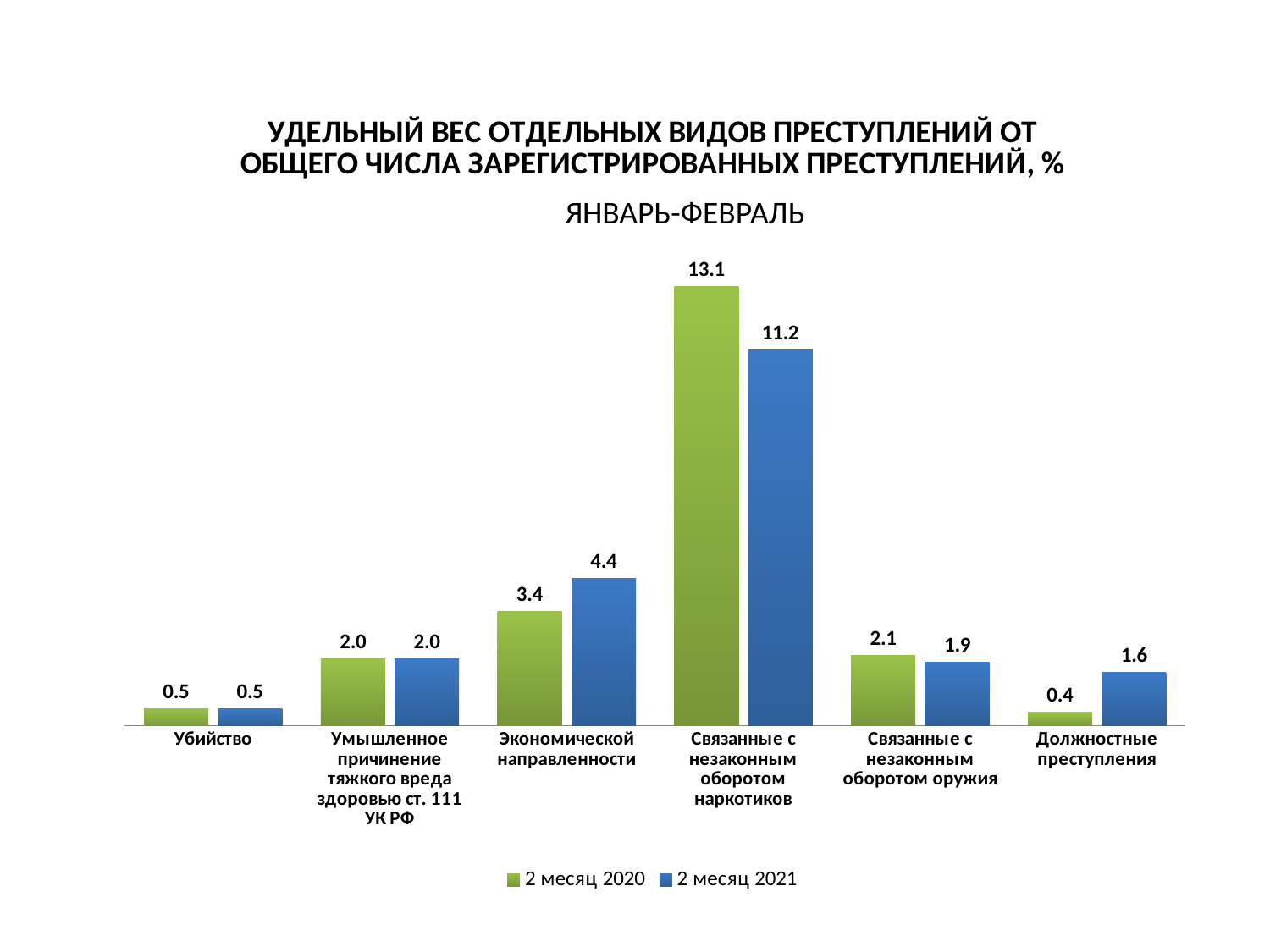
What kind of chart is shown on the slide? Bar chart Which colour represents the '2 месяц 2021' series? Blue What is the value for 'Связанные с незаконным оборотом наркотиков' in the '2 месяц 2021' series? 11.2 Which category has the lowest value in the '2 месяц 2020' series? Должностные преступления Which is larger for 'Связанные с незаконным оборотом оружия': the '2 месяц 2020' value or the '2 месяц 2021' value? 2 месяц 2020 What is the difference between the '2 месяц 2021' and '2 месяц 2020' values for 'Экономической направленности'? 1.0 What is the value for 'Должностные преступления' in the '2 месяц 2021' series? 1.6 How many categories are shown on the x axis? 6 How many series does the legend list? 2 What is the difference between the '2 месяц 2020' and '2 месяц 2021' values for 'Связанные с незаконным оборотом наркотиков'? 1.9 What is the value for 'Экономической направленности' in the '2 месяц 2020' series? 3.4 Which category has the highest value in the '2 месяц 2020' series? Связанные с незаконным оборотом наркотиков